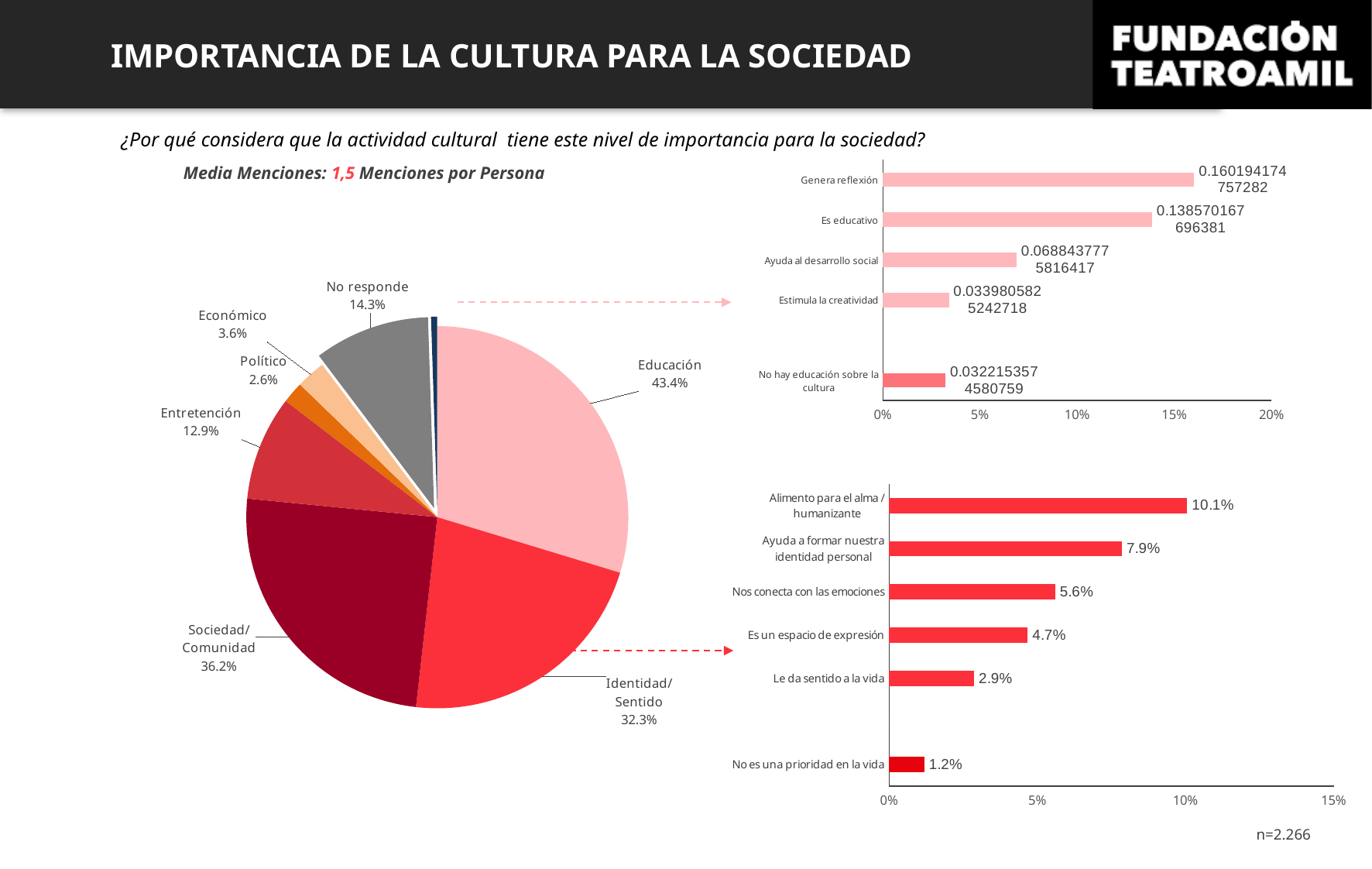
On the bottom-right bar chart, what is the value for Nos conecta con las emociones? 5.6% On the pie chart, what percentage is shown for Educación? 43.4% How many categories are shown on the pie chart? 8 What kind of chart is the chart at the bottom right of the slide? Bar chart On the bottom-right bar chart, which category has the highest value? Alimento para el alma / humanizante On the bottom-right bar chart, what is the difference between Ayuda a formar nuestra identidad personal and Le da sentido a la vida? 5.0% On the pie chart, what is the difference between the percentages for Educación and Identidad/Sentido? 11.1% On the pie chart, what percentage is shown for Sociedad/Comunidad? 36.2% On the top-right bar chart, is the value for Genera reflexión greater or less than 15%? greater On the top-right bar chart, is the value for Estimula la creatividad greater or less than 5%? less On the pie chart, which category has the largest percentage? Educación